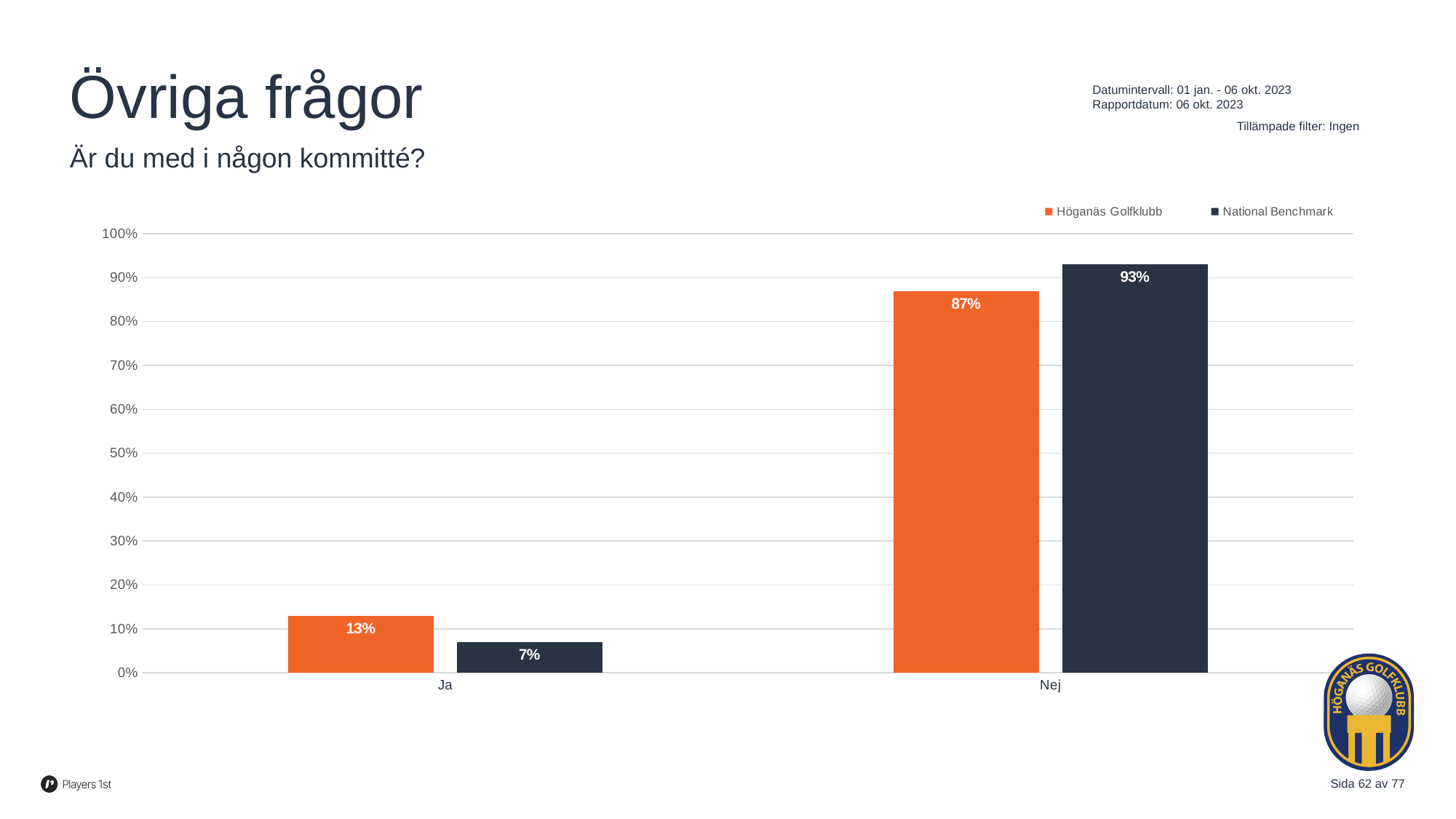
What is the value for National Benchmark in the Ja category? 7% How many categories are shown on the x axis? 2 In the Nej category, which series has the larger value, Höganäs Golfklubb or National Benchmark? National Benchmark What kind of chart is shown on the slide? Bar chart Which category has the lowest value for National Benchmark? Ja What is the value for Höganäs Golfklubb in the Nej category? 87% What is the value for National Benchmark in the Nej category? 93% How many series does the legend list? 2 Which category has the highest value for Höganäs Golfklubb? Nej What is the difference between the National Benchmark and Höganäs Golfklubb values in the Nej category? 6% What is the difference between the Höganäs Golfklubb and National Benchmark values in the Ja category? 6% What is the value for Höganäs Golfklubb in the Ja category? 13%